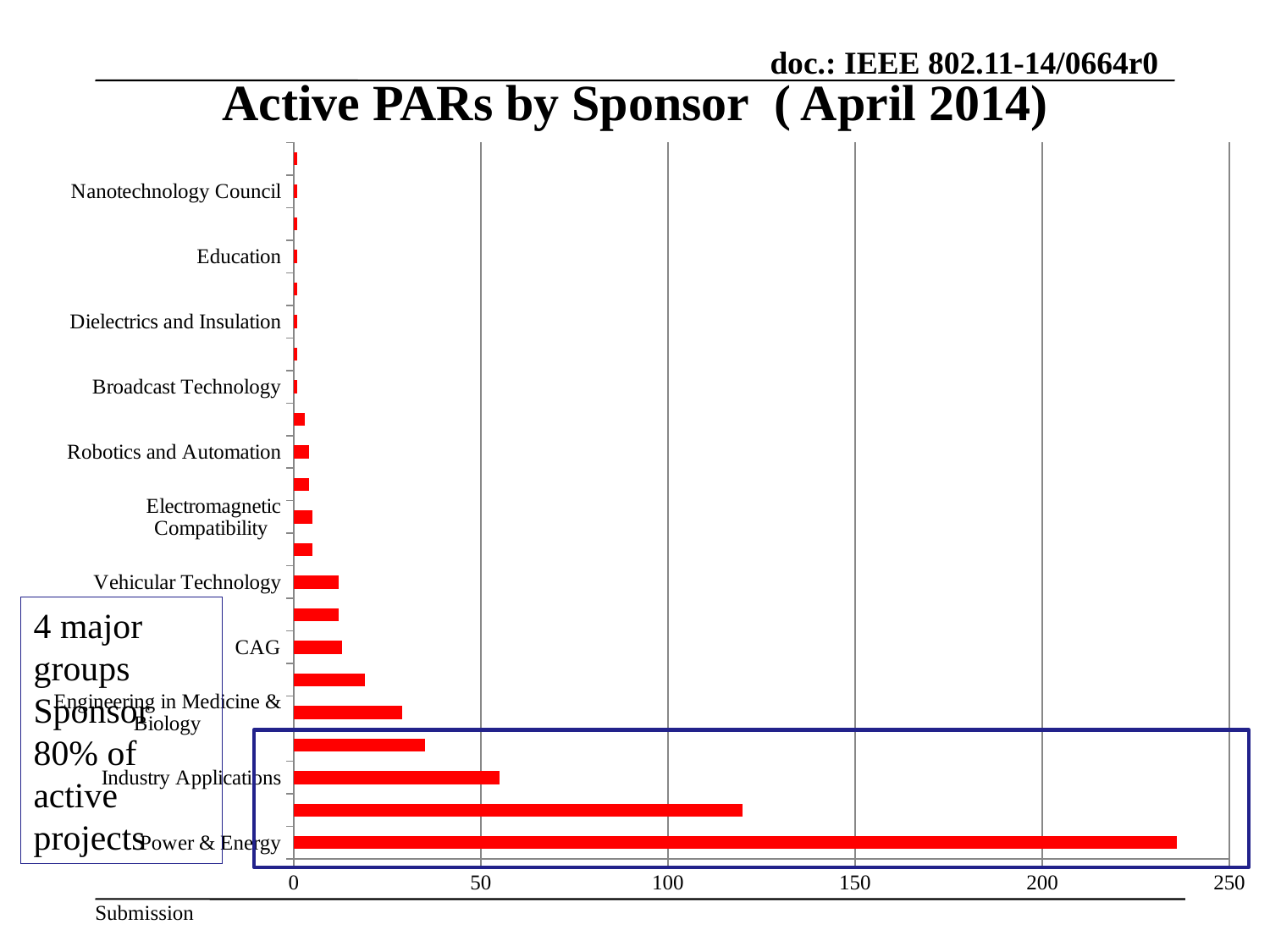
Which has more active PARs, Power & Energy or Industry Applications? Power & Energy What is the highest value shown on the horizontal axis? 250 Is the value for Power & Energy greater or less than 200? greater Which has more active PARs, Industry Applications or Engineering in Medicine & Biology? Industry Applications Is the value for Industry Applications greater or less than 100? less What kind of chart is shown on the slide? bar chart Is the value for Vehicular Technology greater or less than 50? less Which has more active PARs, Engineering in Medicine & Biology or Robotics and Automation? Engineering in Medicine & Biology Which sponsor has the highest number of active PARs? Power & Energy What is the title of the chart? Active PARs by Sponsor (April 2014)